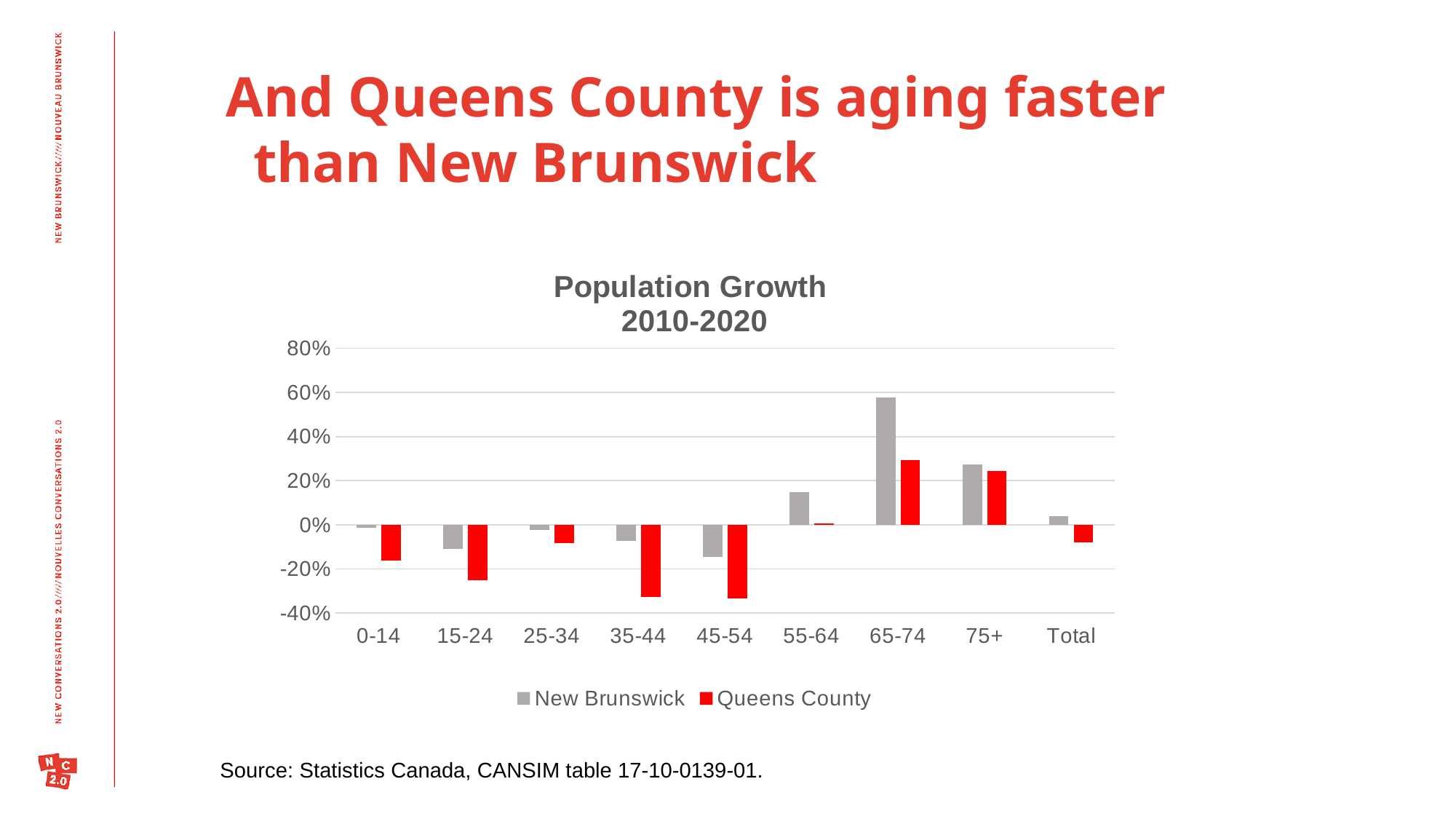
What is the title of the chart? Population Growth 2010-2020 Is the Queens County value for 75+ greater or less than 20%? greater Which age group has the highest population growth for New Brunswick? 65-74 Is the Queens County value for 35-44 greater or less than -20%? less Which age group has the lowest population growth for New Brunswick? 45-54 What kind of chart is shown on the slide? Bar chart Is the New Brunswick value for 65-74 greater or less than 40%? greater How many series does the legend list? 2 For the 65-74 age group, which series has the higher value, New Brunswick or Queens County? New Brunswick Which age group has the highest population growth for Queens County? 65-74 How many categories are shown along the x axis? 9 For the Total category, which series has the higher value, New Brunswick or Queens County? New Brunswick